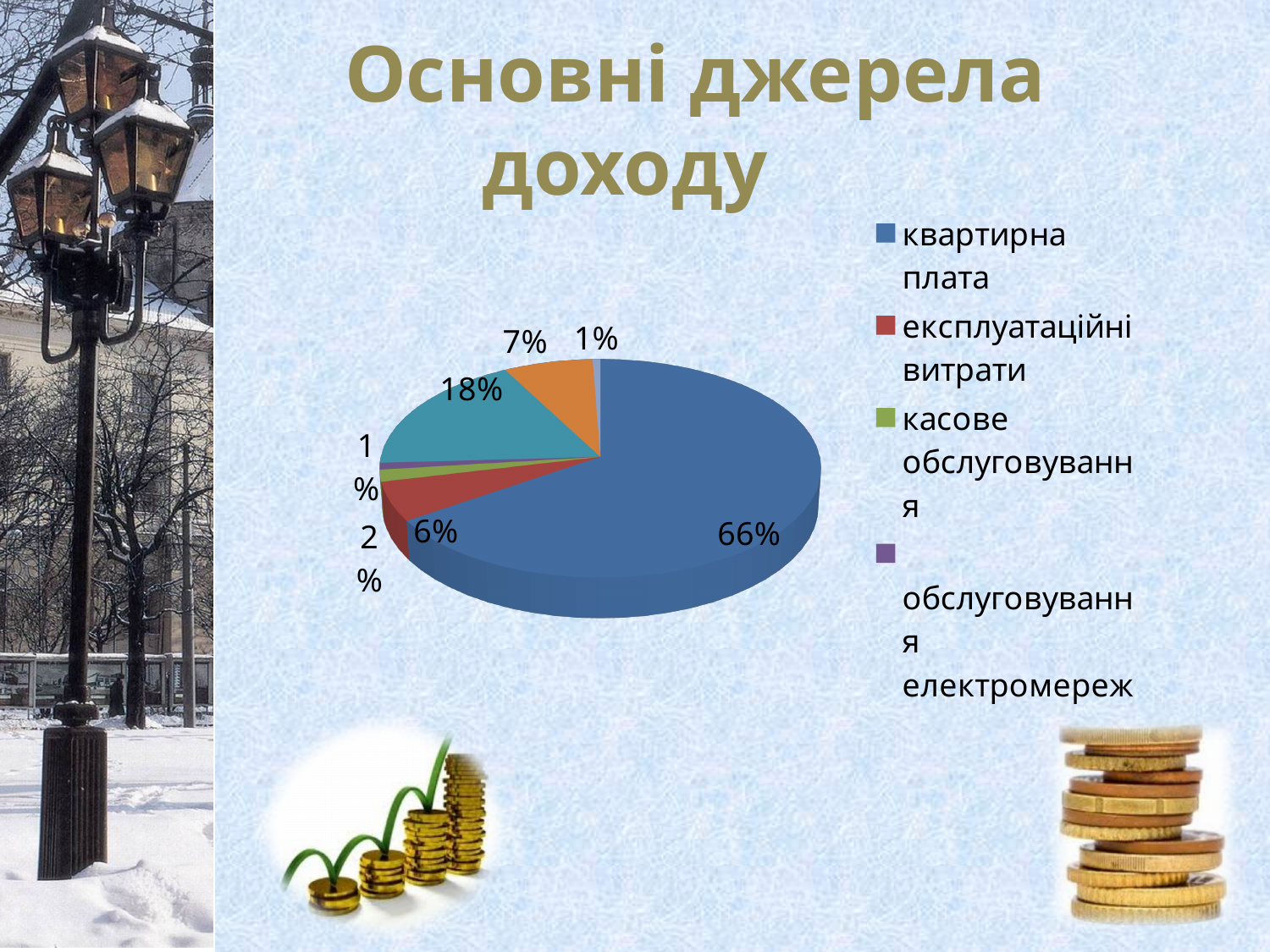
What share of the pie does квартирна плата take? 66% Which category has the largest slice of the pie? квартирна плата What share of the pie does експлуатаційні витрати take? 6% What is the difference in percentage points between the largest slice (66%) and the 18% slice? 48 What is the title of the chart? Основні джерела доходу Which is larger: експлуатаційні витрати or касове обслуговування? експлуатаційні витрати What is the value of the second-largest slice in the pie? 18% What share of the pie does обслуговування електромереж take? 1% What type of chart is shown on the slide? pie chart How many slices does the pie chart have? 7 How many entries are visible in the chart legend? 4 What share of the pie does касове обслуговування take? 2%